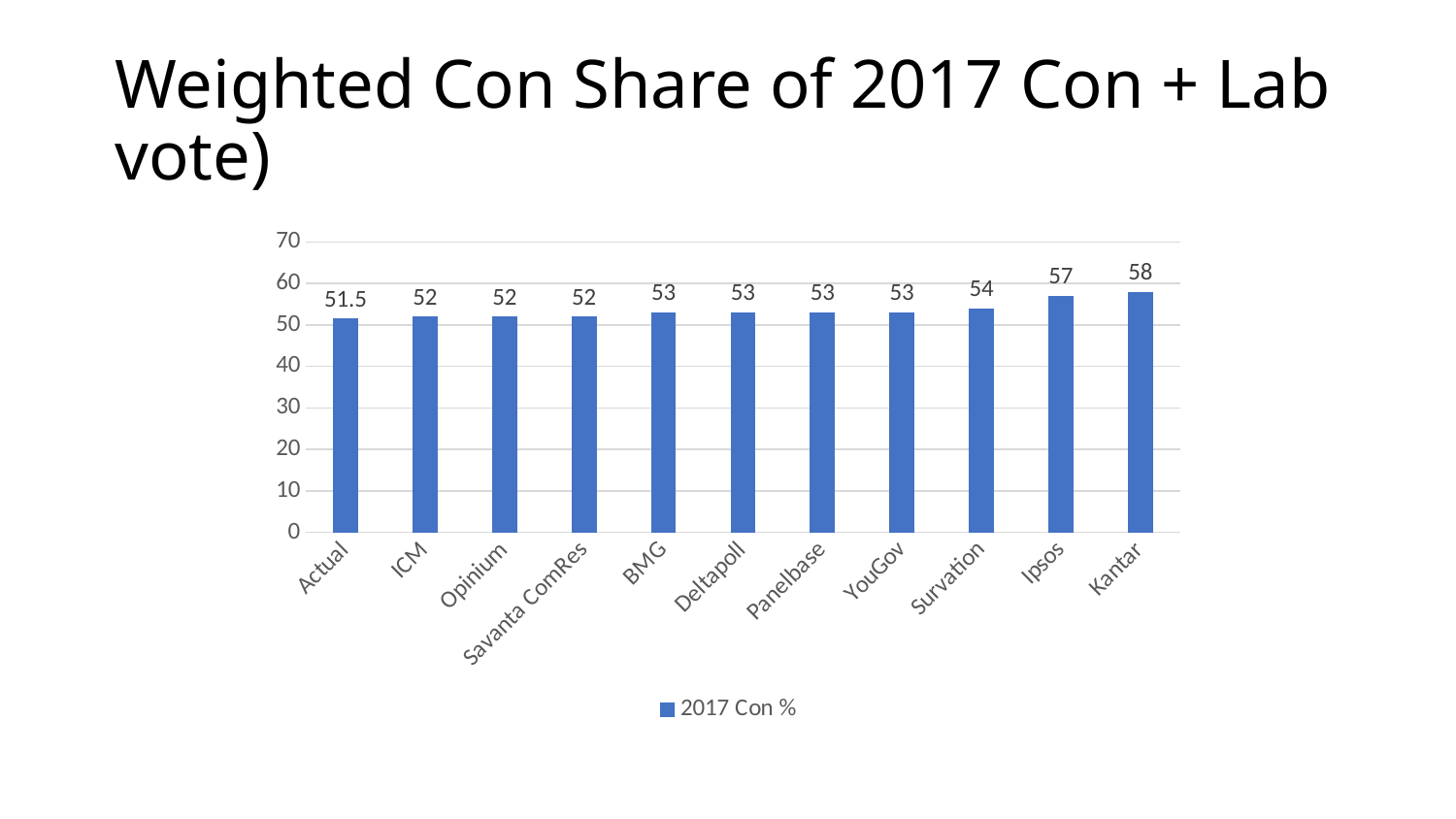
Is the value for BMG greater or less than 40? greater Which category has the highest value? Kantar What is the value for Actual? 51.5 Which category has the lowest value? Actual What kind of chart is shown on the slide? Bar chart What is the value for Survation? 54 What series name does the legend show? 2017 Con % What is the value for Kantar? 58 What is the difference between the values for Kantar and Actual? 6.5 What is the value for Ipsos? 57 How many categories are shown on the x axis? 11 Which is larger, the value for Ipsos or the value for Survation? Ipsos